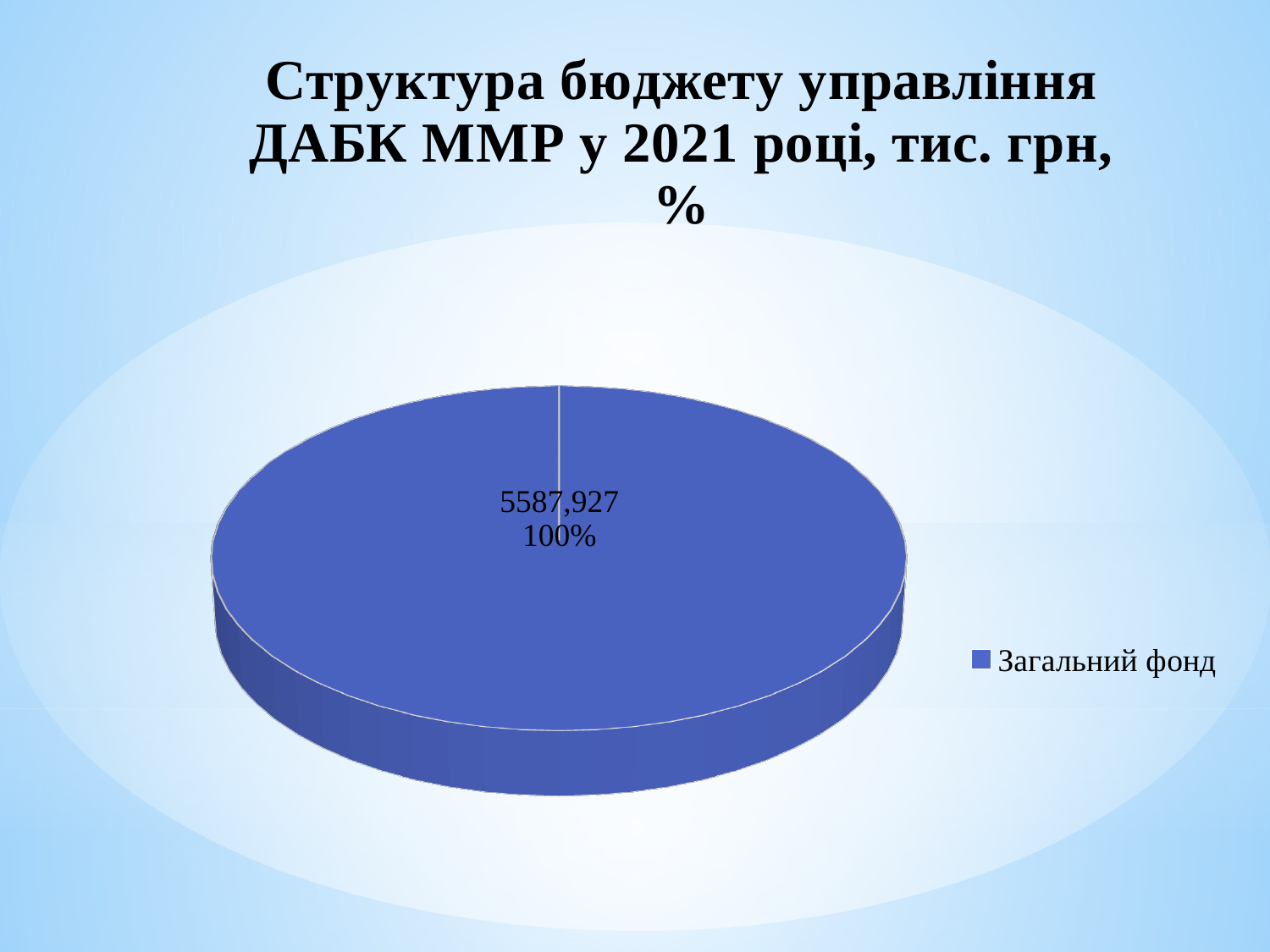
What kind of chart is shown on the slide? pie chart What is the value shown for Загальний фонд? 5587,927 What share of the pie does Загальний фонд represent? 100% What is the name of the only category in the legend? Загальний фонд How many entries does the legend list? 1 How many slices does the pie chart have? 1 Is the value for Загальний фонд greater or less than 5000? greater What is the title of the chart? Структура бюджету управління ДАБК ММР у 2021 році, тис. грн, %